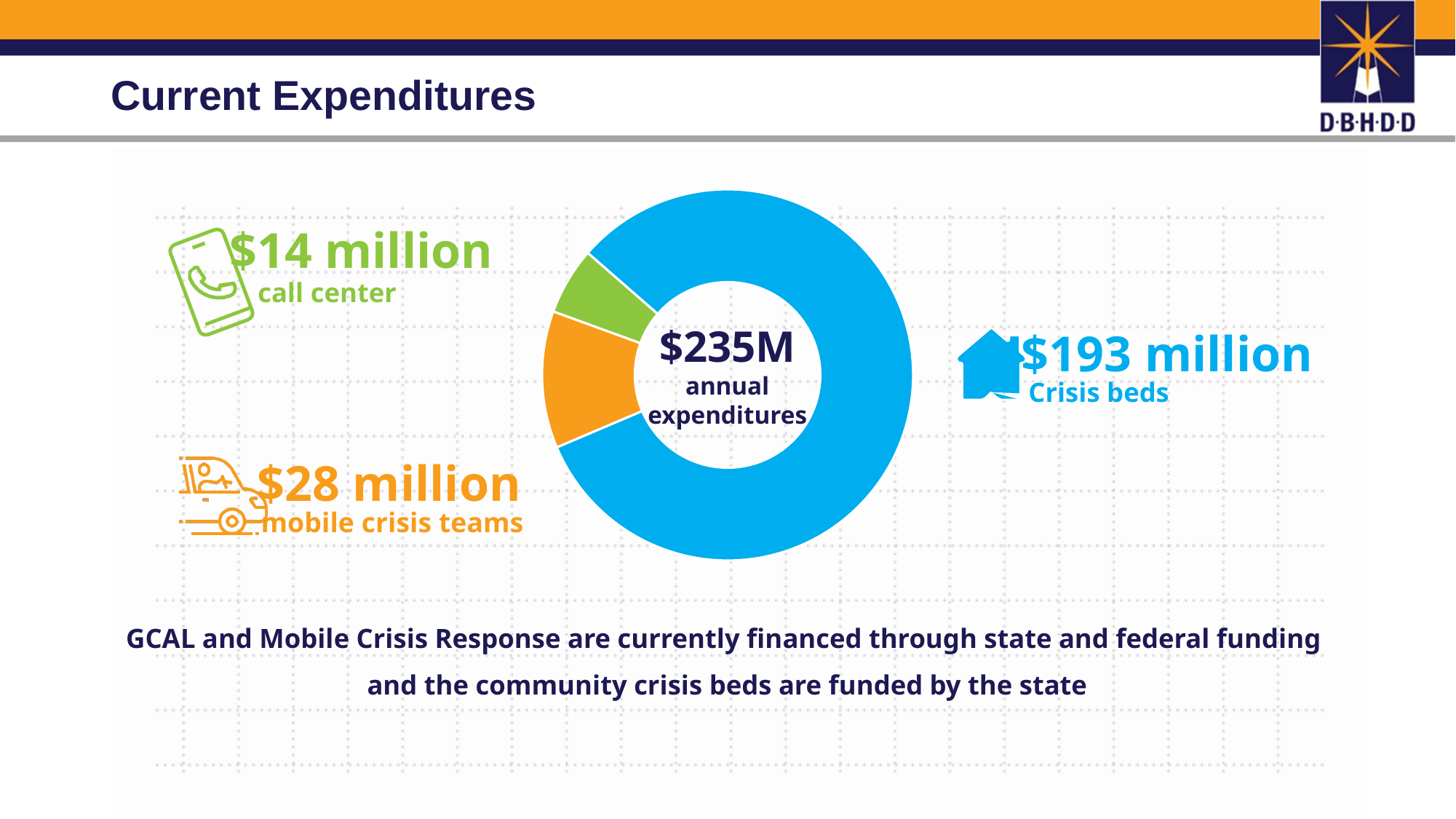
Which is larger, the expenditure on mobile crisis teams or on the call center? Mobile crisis teams Which colour represents crisis beds in the chart? Blue What total annual expenditure is shown in the center of the donut chart? $235M How much more is spent on crisis beds than on mobile crisis teams? $165 million What is the difference between the mobile crisis teams and call center expenditures? $14 million What type of chart is used on this slide? Donut (pie) chart How much is spent on the call center? $14 million Which category accounts for the smallest expenditure? Call center How much is spent on mobile crisis teams? $28 million Which category accounts for the largest expenditure? Crisis beds What is the annual expenditure for crisis beds? $193 million How many expenditure categories are shown in the donut chart? 3